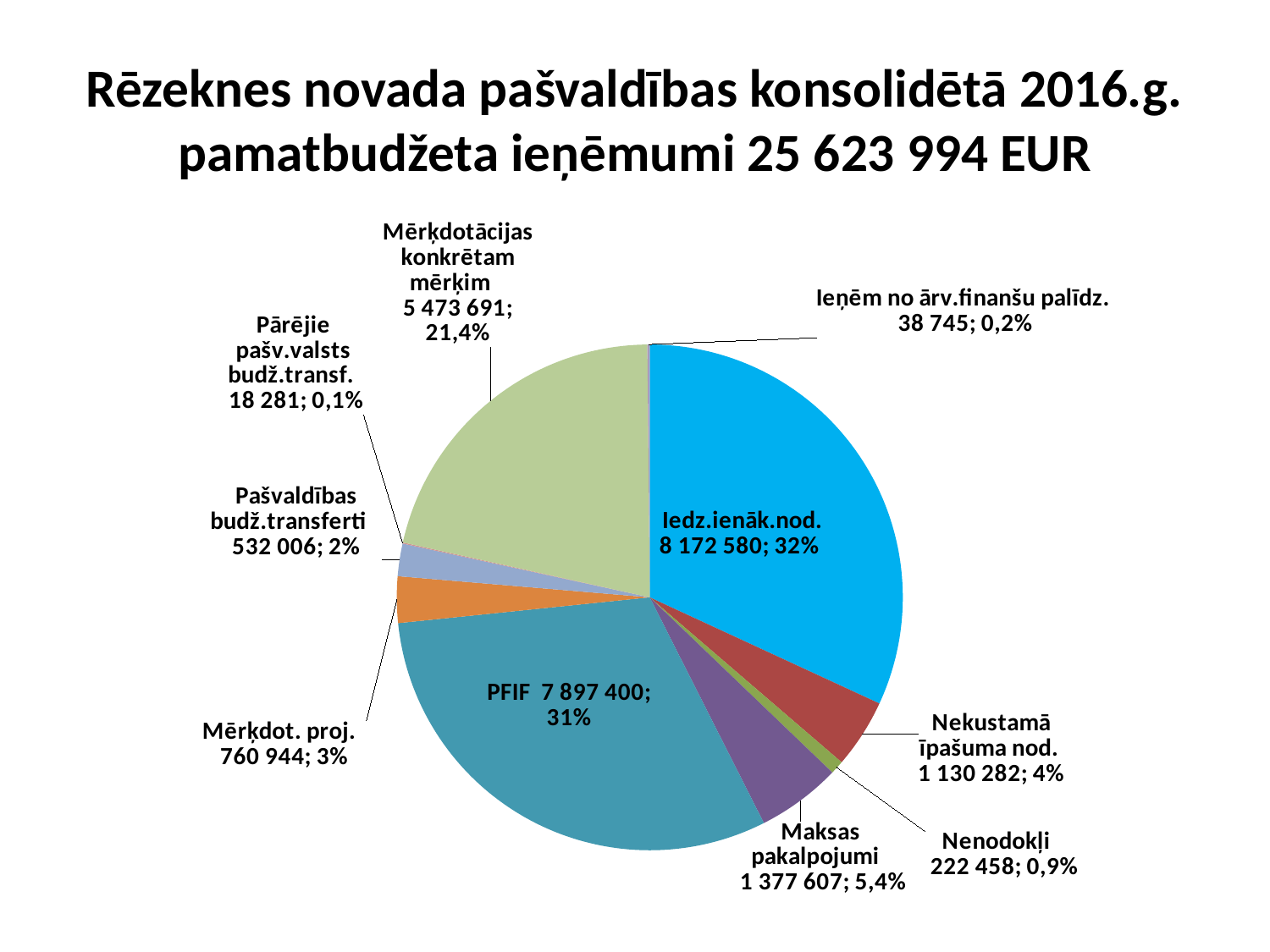
What is the value for Nenodokļi? 222 458 What is the value for PFIF? 7 897 400 Which category has the smallest slice of the pie? Pārējie pašv.valsts budž.transf. What share of the pie does Mērķdotācijas konkrētam mērķim represent? 21,4% Which is larger, the value for Mērķdot. proj. or the value for Pašvaldības budž.transferti? Mērķdot. proj. What share of the pie does Nekustamā īpašuma nod. represent? 4% What is the difference between the values for Iedz.ienāk.nod. and PFIF? 275 180 How many slices does the pie chart have? 10 What kind of chart is shown on the slide? pie chart What is the value for Maksas pakalpojumi? 1 377 607 What is the value for Iedz.ienāk.nod.? 8 172 580 Which category has the largest slice of the pie? Iedz.ienāk.nod.